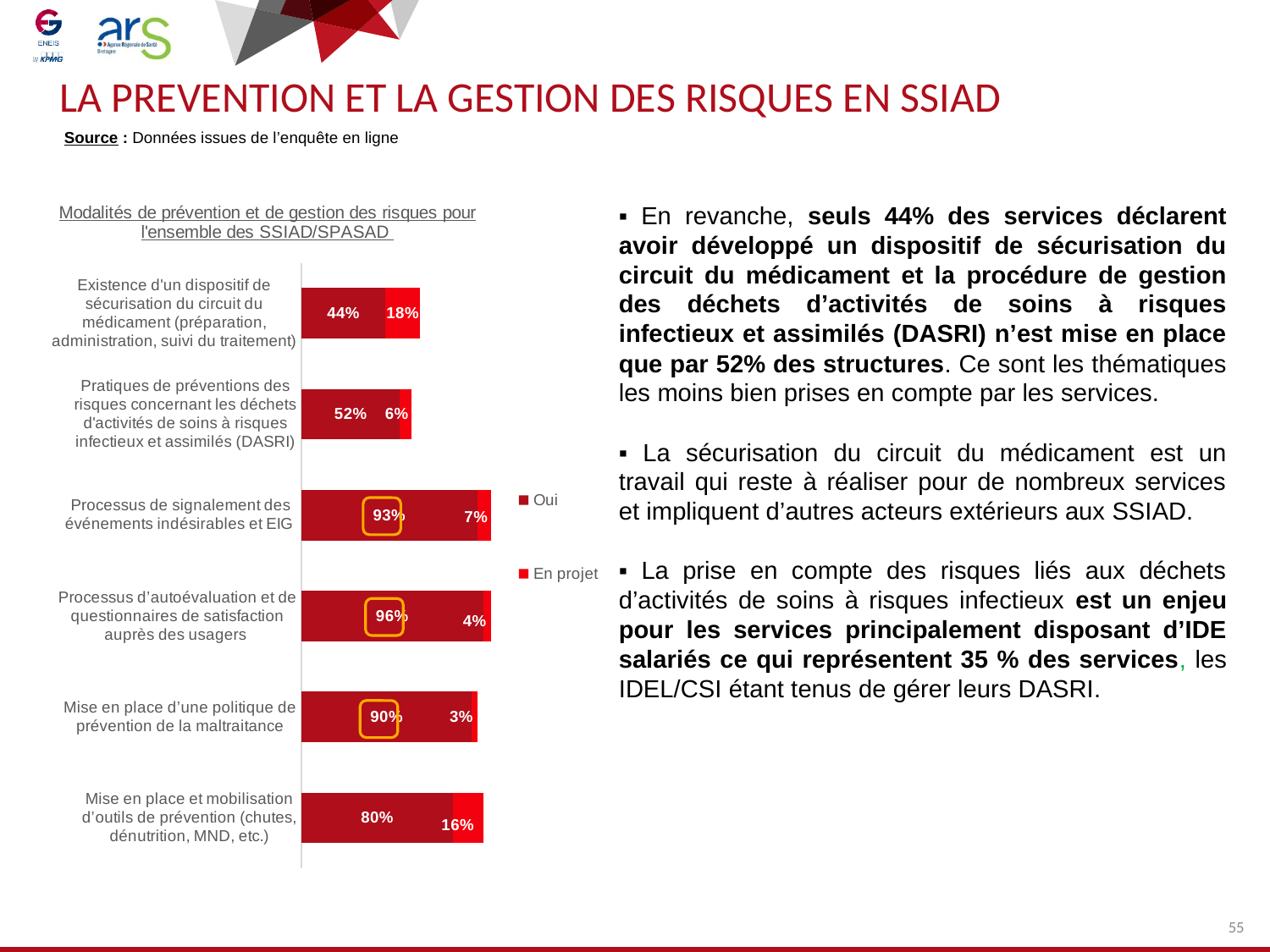
How many series does the chart legend list? 2 What is the 'En projet' value for 'Mise en place et mobilisation d'outils de prévention (chutes, dénutrition, MND, etc.)'? 16% Which is larger: the 'En projet' value for 'Existence d'un dispositif de sécurisation du circuit du médicament' or for 'Pratiques de préventions des risques concernant les déchets DASRI'? Existence d'un dispositif de sécurisation du circuit du médicament What is the difference between the 'Oui' values for 'Pratiques de préventions des risques concernant les déchets DASRI' and 'Existence d'un dispositif de sécurisation du circuit du médicament'? 8% Which category has the highest 'Oui' value? Processus d'autoévaluation et de questionnaires de satisfaction auprès des usagers What is the 'Oui' value for 'Existence d'un dispositif de sécurisation du circuit du médicament'? 44% What is the 'Oui' value for 'Processus de signalement des événements indésirables et EIG'? 93% What type of chart is shown on the slide? Stacked bar chart Which category has the lowest 'Oui' value? Existence d'un dispositif de sécurisation du circuit du médicament (préparation, administration, suivi du traitement) What is the total of the stacked bar for 'Mise en place d'une politique de prévention de la maltraitance'? 93% How many categories are plotted in the chart? 6 What is the title of the chart? Modalités de prévention et de gestion des risques pour l'ensemble des SSIAD/SPASAD